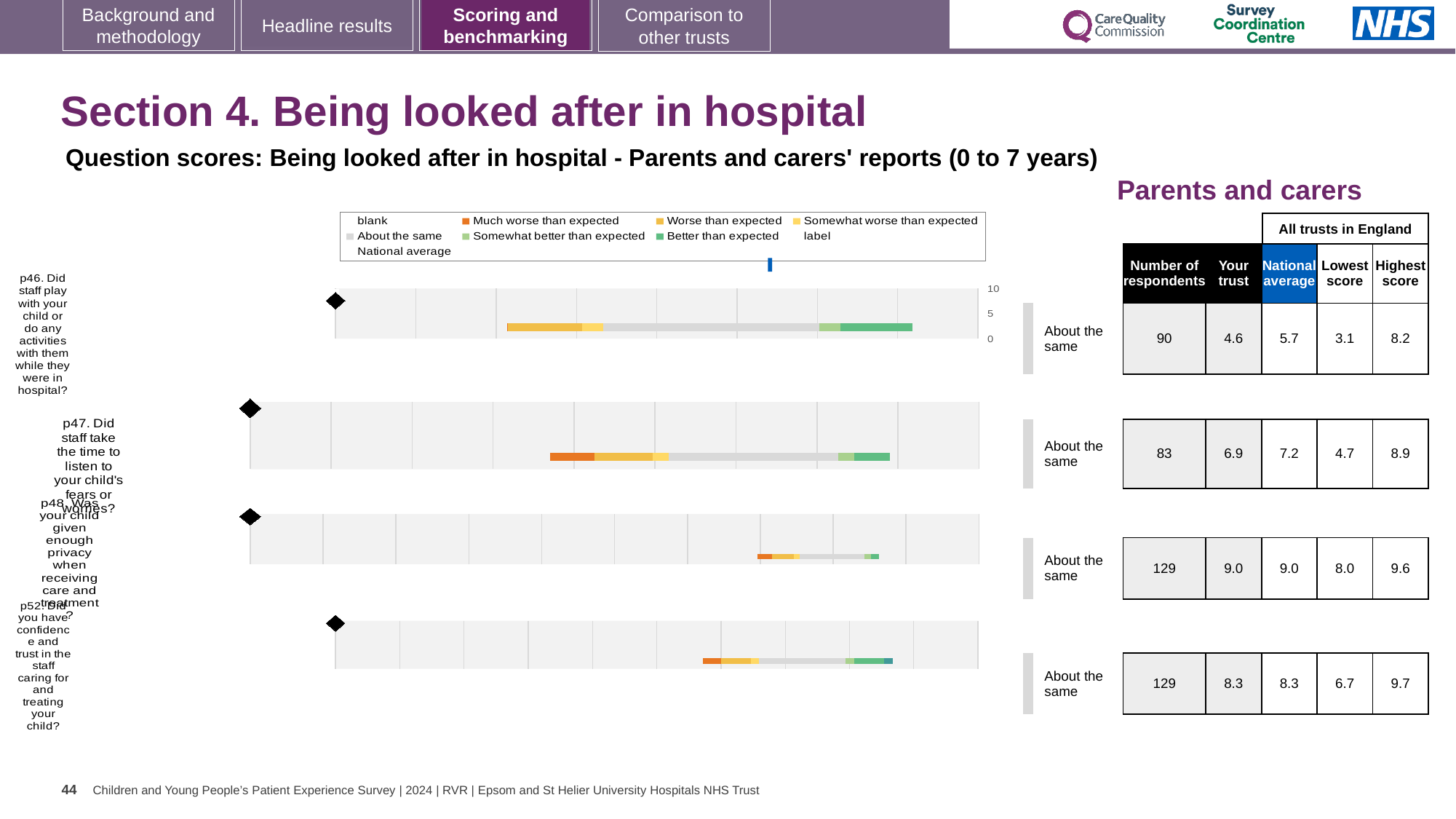
According to the table beside the charts, which question has the highest 'Your trust' score? p48 How many question charts are shown on the slide? 4 According to the table beside the charts, what is the 'Your trust' score for p46 (Did staff play with your child or do any activities with them while they were in hospital?)? 4.6 According to the table beside the charts, how many respondents answered p48? 129 For p46, what is the difference between the national average (5.7) and the 'Your trust' score (4.6) shown in the table? 1.1 According to the table beside the charts, what is the 'Your trust' score for p47 (Did staff take the time to listen to your child's fears or worries?)? 6.9 What benchmark category label is shown to the right of each of the four charts? About the same What kind of chart is used to show the question scores on this slide? bar chart In the chart legend, what colour represents 'Much worse than expected'? Orange According to the table beside the charts, which question has the lowest 'Your trust' score? p46 According to the table beside the charts, what is the national average for p52 (Did you have confidence and trust in the staff caring for and treating your child?)? 8.3 For p47, which is larger in the table: the 'Your trust' score or the national average? National average